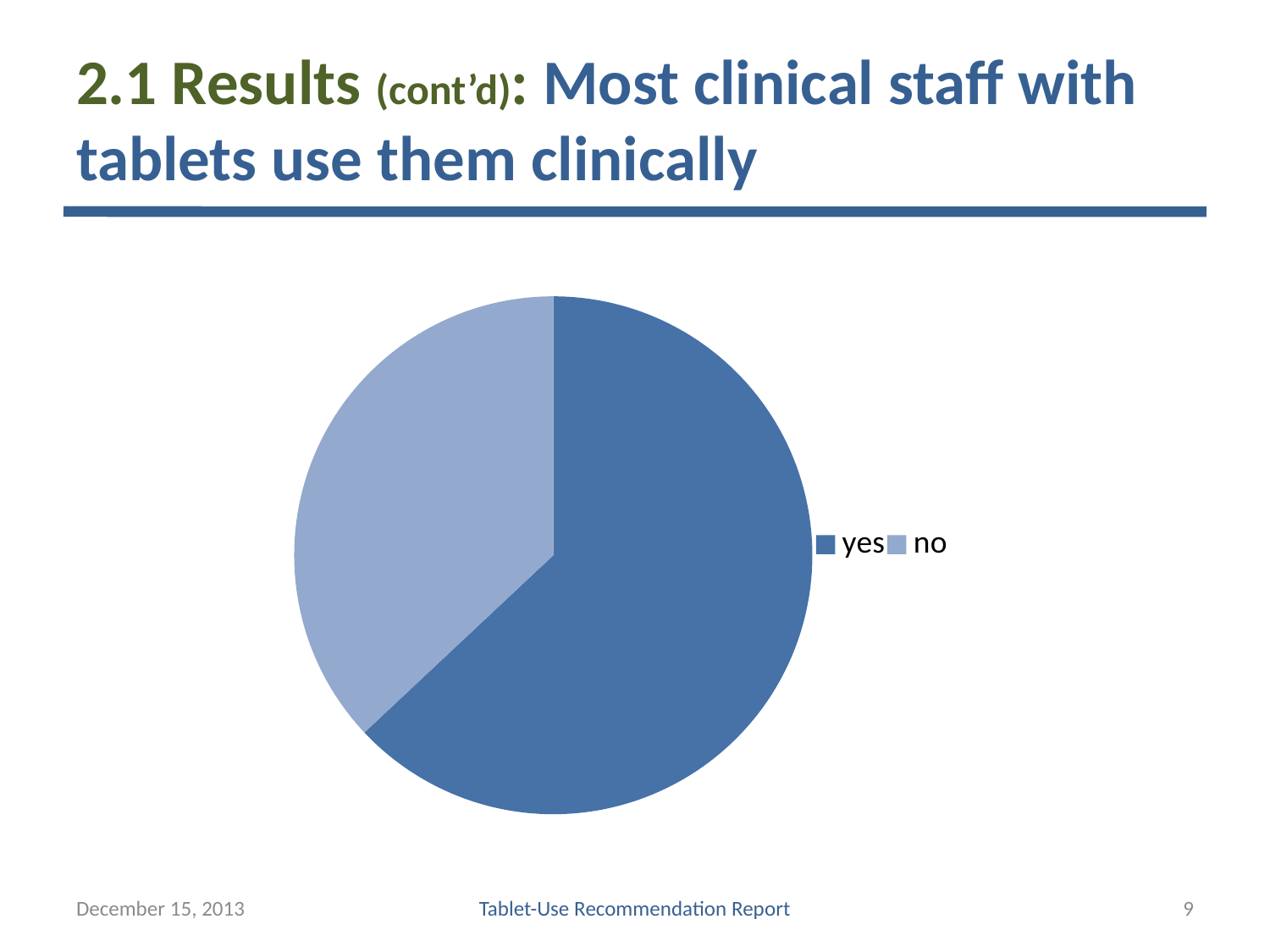
Which slice is larger, yes or no? yes Which slice of the pie chart is the largest? yes How many slices does the pie chart have? 2 What are the two legend entries of the pie chart? yes, no Which legend entry is shown in the darker blue colour? yes What kind of chart is shown on the slide? pie chart How many entries does the legend list? 2 Which slice of the pie chart is the smallest? no